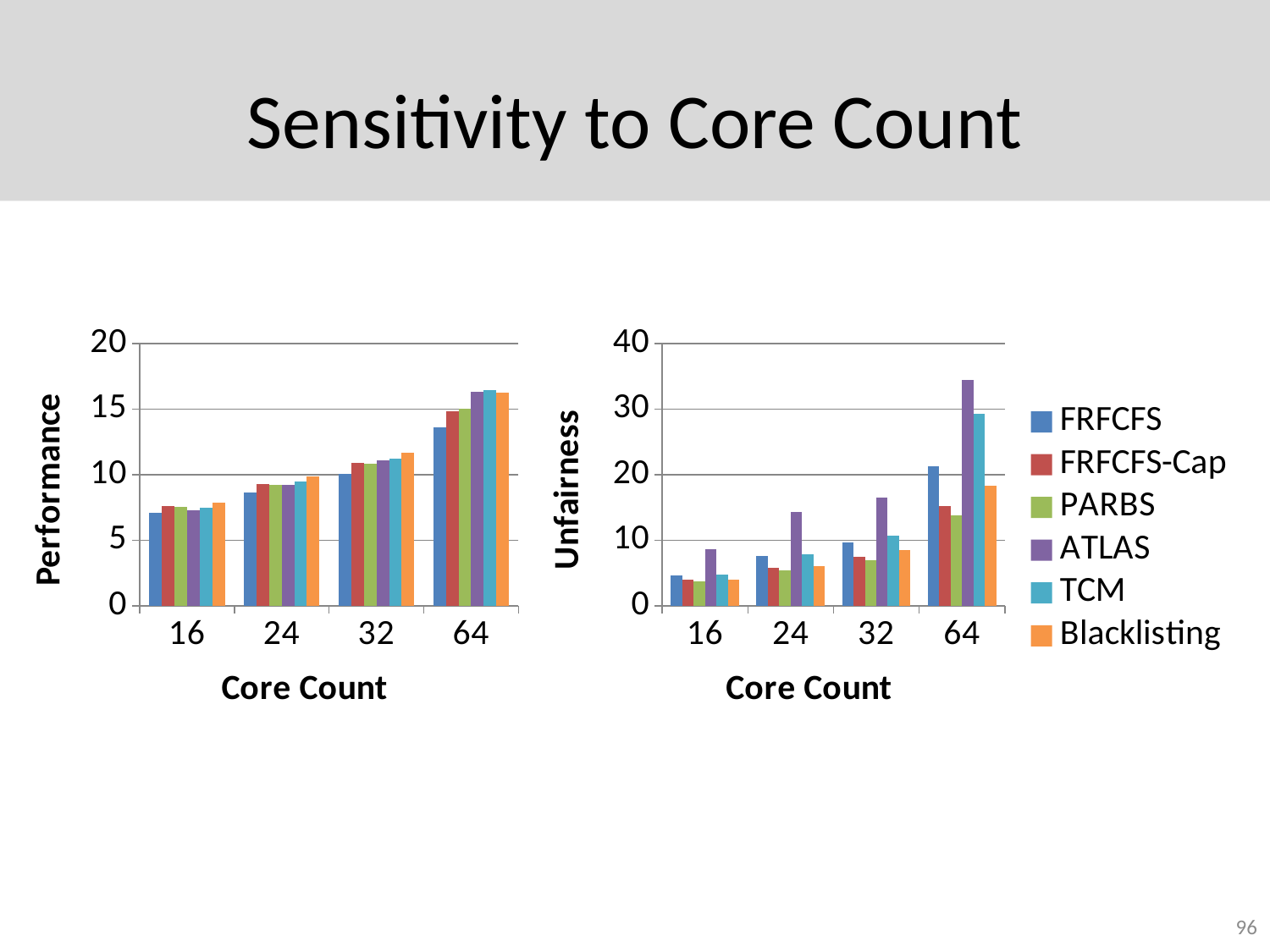
In the Unfairness chart at 64 cores, which is larger, ATLAS or TCM? ATLAS In the Performance chart, is the value for FRFCFS at 64 cores greater or less than 10? greater In the Performance chart, is the value for Blacklisting at 16 cores greater or less than 10? less What is the x-axis label of the Unfairness chart? Core Count In the Unfairness chart, is the value for Blacklisting at 64 cores greater or less than 20? less In the Performance chart, do the values rise or fall as the core count increases along the x axis? rise In the Unfairness chart, which series has the highest value at 64 cores? ATLAS How many series does the legend list? 6 How many core count categories are shown on the x axis of the Unfairness chart? 4 In the Unfairness chart, which series has the lowest value at 64 cores? PARBS What kind of chart is the left chart (Performance vs Core Count)? bar chart